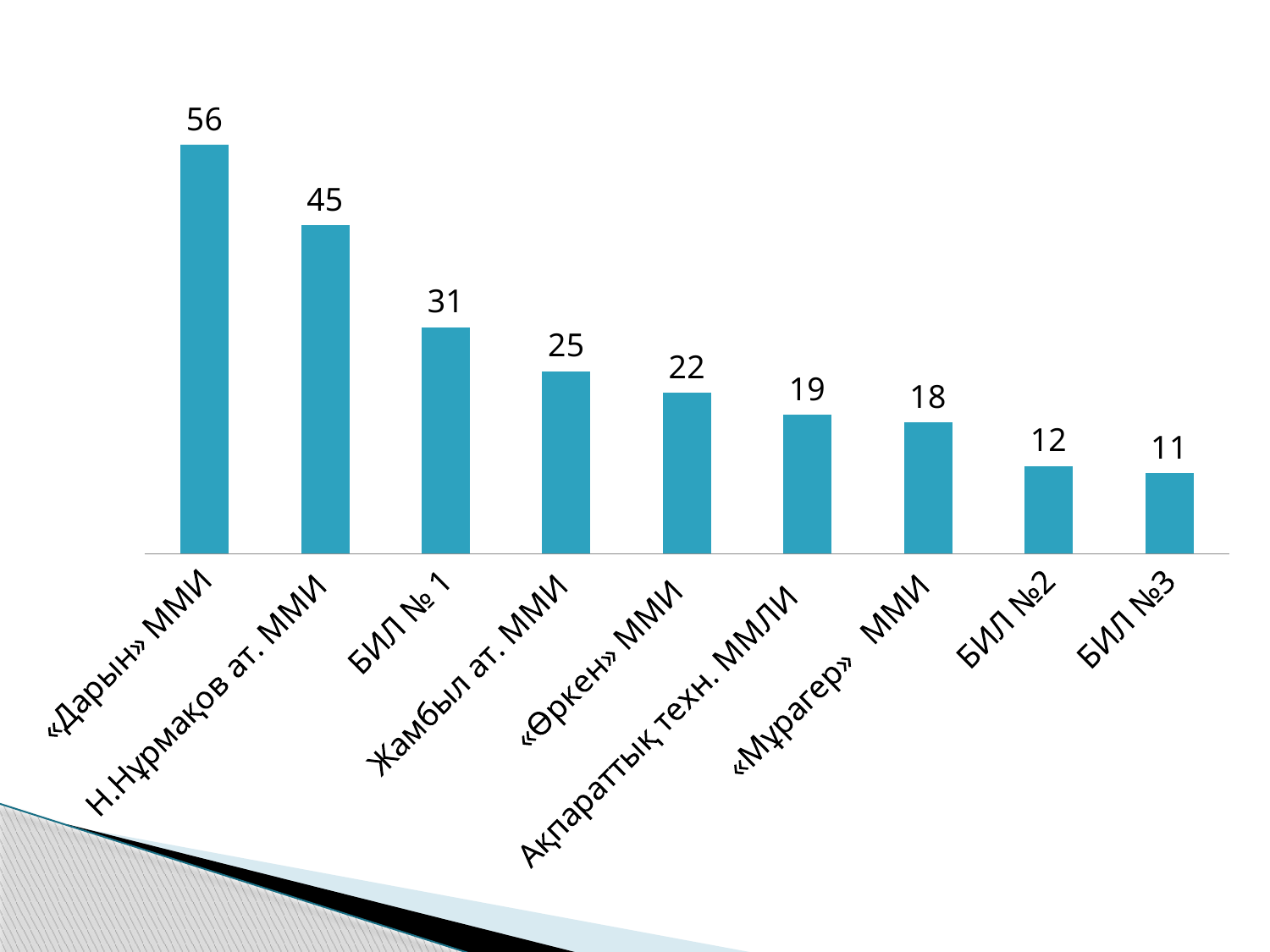
Which category has the highest value? «Дарын» ММИ What is the value for БИЛ № 1? 31 What kind of chart is shown on the slide? bar chart What is the difference between the values for «Дарын» ММИ and Н.Нұрмақов ат. ММИ? 11 Do the values rise or fall from left to right along the x axis? fall Which is larger, the value for «Өркен» ММИ or the value for «Мұрагер» ММИ? «Өркен» ММИ What is the value for «Дарын» ММИ? 56 What is the difference between the values for Жамбыл ат. ММИ and БИЛ №2? 13 Which category has the lowest value? БИЛ №3 How many categories are shown in the chart? 9 What is the value for Ақпараттық техн. ММЛИ? 19 What is the value for БИЛ №3? 11